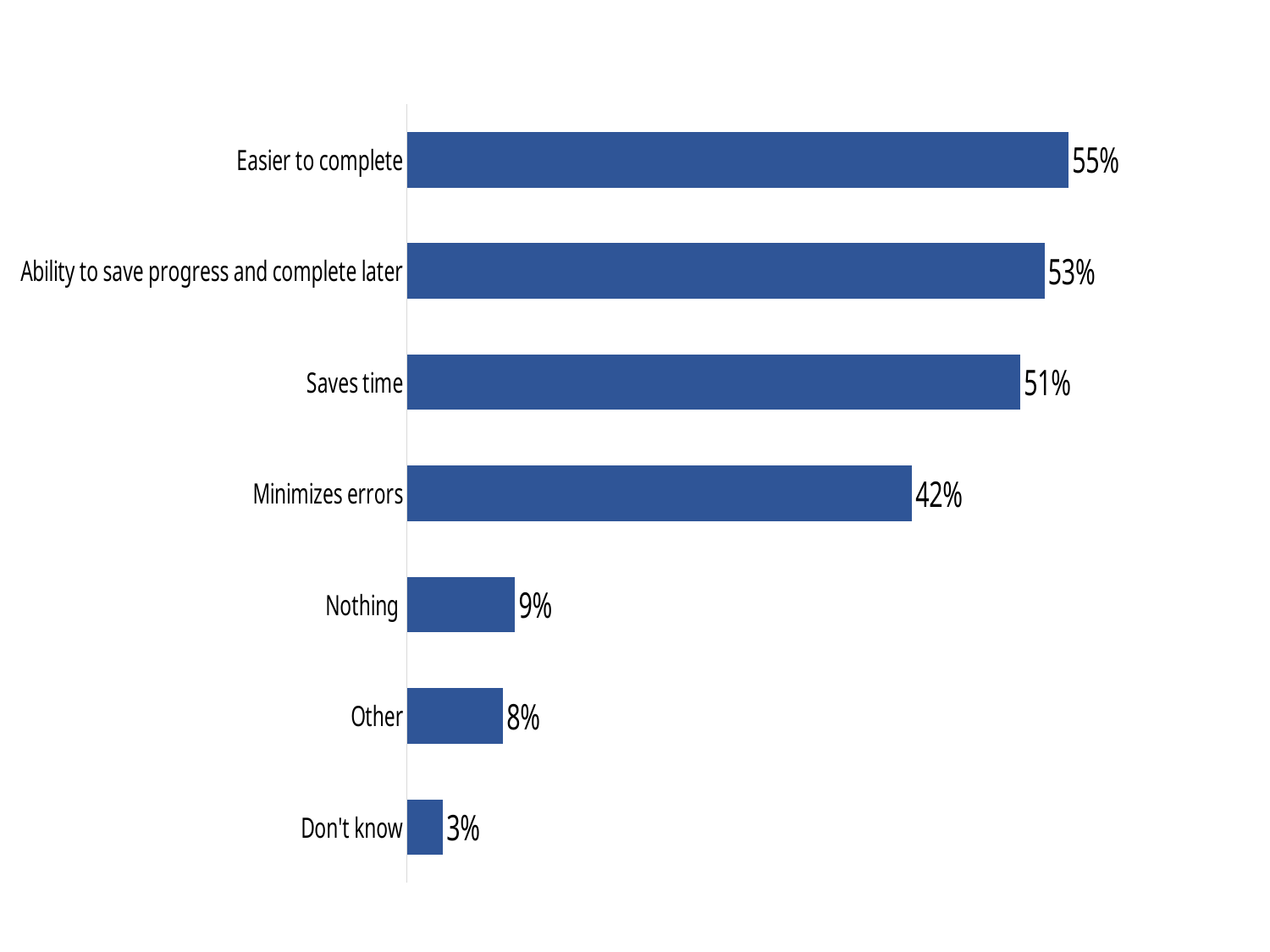
How many categories are shown in the chart? 7 What is the value for Don't know? 3% What kind of chart is this? Bar chart What is the value for Minimizes errors? 42% What is the difference between the values for Saves time and Minimizes errors? 9% Which category has the highest value? Easier to complete What is the difference between the values for Nothing and Other? 1% Which category has the lowest value? Don't know What colour are the bars in the chart? Blue What is the value for Ability to save progress and complete later? 53% Which is larger, the value for Minimizes errors or the value for Nothing? Minimizes errors What is the value for Easier to complete? 55%